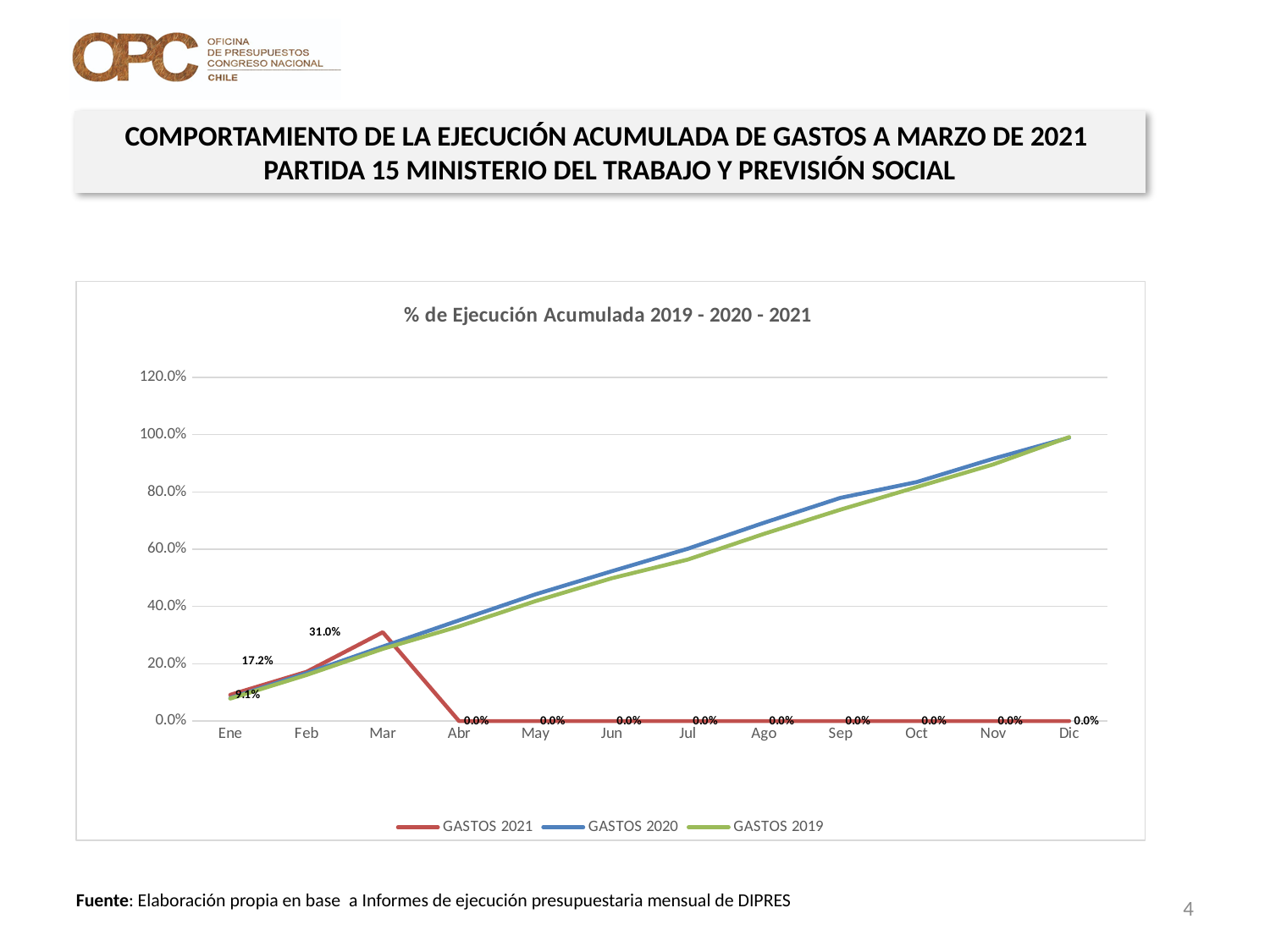
What is the value of GASTOS 2021 in Mar? 31.0% Is the value for GASTOS 2020 in Sep greater or less than 60.0%? greater How many months are shown on the x axis? 12 What is the value of GASTOS 2021 in Abr? 0.0% What kind of chart is shown? Line chart What is the difference between the GASTOS 2021 values for Mar and Feb? 13.8 percentage points What is the value of GASTOS 2021 in Ene? 9.1% In which month does GASTOS 2021 reach its highest value? Mar What is the value of GASTOS 2021 in Feb? 17.2% How many series does the legend list? 3 Does the GASTOS 2020 line rise or fall from Ene to Dic? Rises What is the title of the chart? % de Ejecución Acumulada 2019 - 2020 - 2021